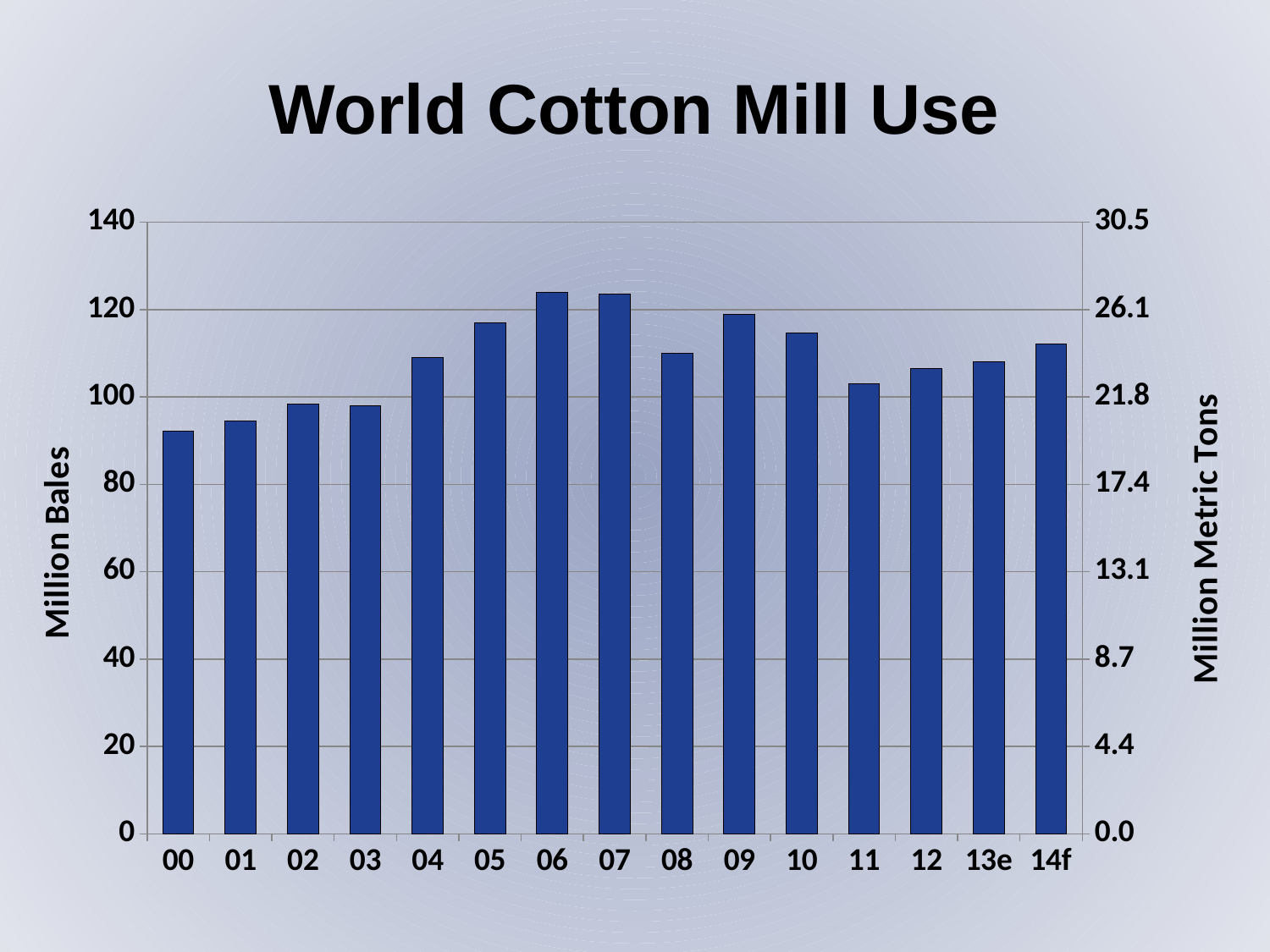
What kind of chart is shown on the slide? bar chart Which is larger, the value for 05 or the value for 04? 05 What is the label of the right-hand vertical axis? Million Metric Tons Is the value for 00 greater or less than 100 million bales? less Is the value for 06 greater or less than 120 million bales? greater Is the value for 05 greater or less than 120 million bales? less How many years (categories) are plotted on the x axis? 15 Which is larger, the value for 08 or the value for 09? 09 What is the title of the chart? World Cotton Mill Use Do the values rise or fall from 00 to 06? rise Which year has the lowest world cotton mill use? 00